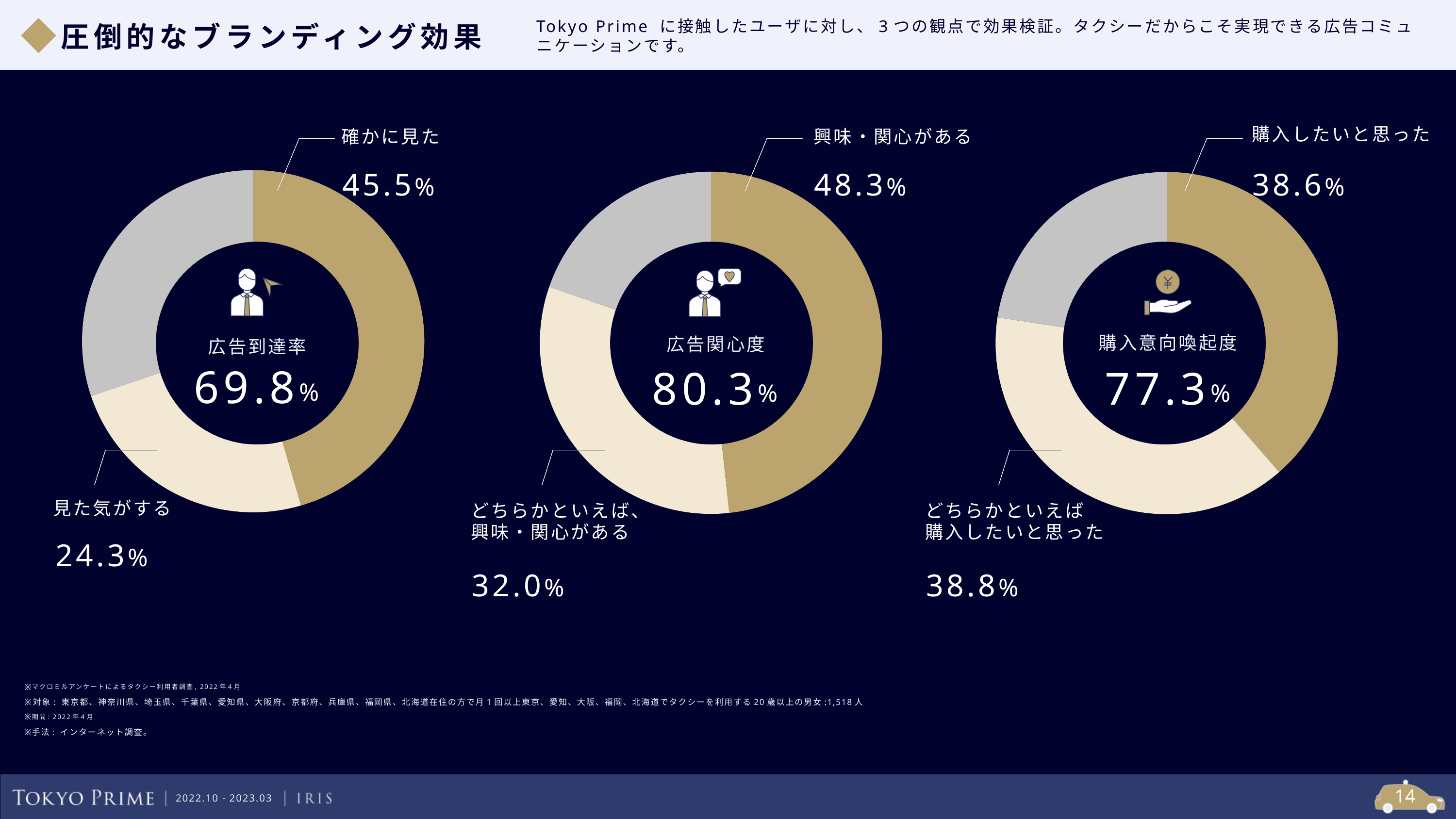
In the 広告到達率 chart on the left, which labelled slice is larger, 確かに見た or 見た気がする? 確かに見た How many donut charts are shown on the slide? 3 In the 購入意向喚起度 chart on the right, what percentage is shown for 購入したいと思った? 38.6% In the 広告関心度 chart in the middle, what is the difference between 興味・関心がある and どちらかといえば、興味・関心がある? 16.3% In the 広告関心度 chart in the middle, what percentage is shown for どちらかといえば、興味・関心がある? 32.0% What is the overall value shown in the centre of the 広告到達率 chart on the left? 69.8% What is the overall value shown in the centre of the 購入意向喚起度 chart on the right? 77.3% In the 広告到達率 chart on the left, what percentage is shown for 確かに見た? 45.5% In the 広告関心度 chart in the middle, what percentage is shown for 興味・関心がある? 48.3% Which of the three charts has the highest overall centre value? 広告関心度 In the 広告到達率 chart on the left, what percentage is shown for 見た気がする? 24.3% What kind of chart is used for 広告到達率, 広告関心度 and 購入意向喚起度? Donut (pie) chart